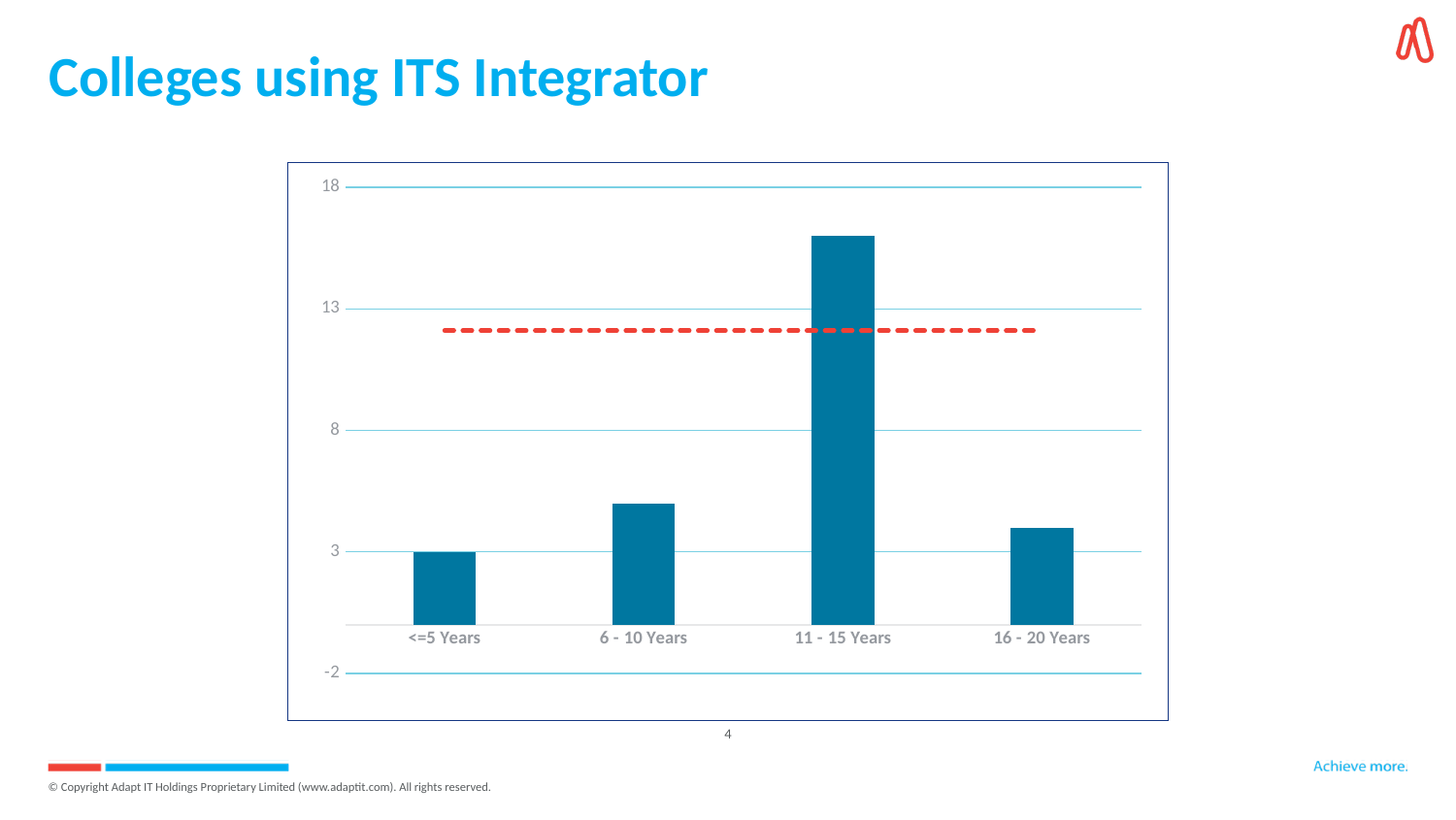
What is the title of the slide containing the chart? Colleges using ITS Integrator Is the value for 6 - 10 Years greater or less than 3? greater Which category has the lowest bar in the chart? <=5 Years How many categories are shown on the x axis of the chart? 4 Is the value for 11 - 15 Years greater or less than 13? greater Which category has the highest bar in the chart? 11 - 15 Years What is the value for <=5 Years in the chart? 3 Which is larger, the value for 6 - 10 Years or the value for 16 - 20 Years? 6 - 10 Years Is the value for 6 - 10 Years greater or less than 8? less What kind of chart is shown on the slide? bar chart What colour is the dashed horizontal line drawn across the chart? red